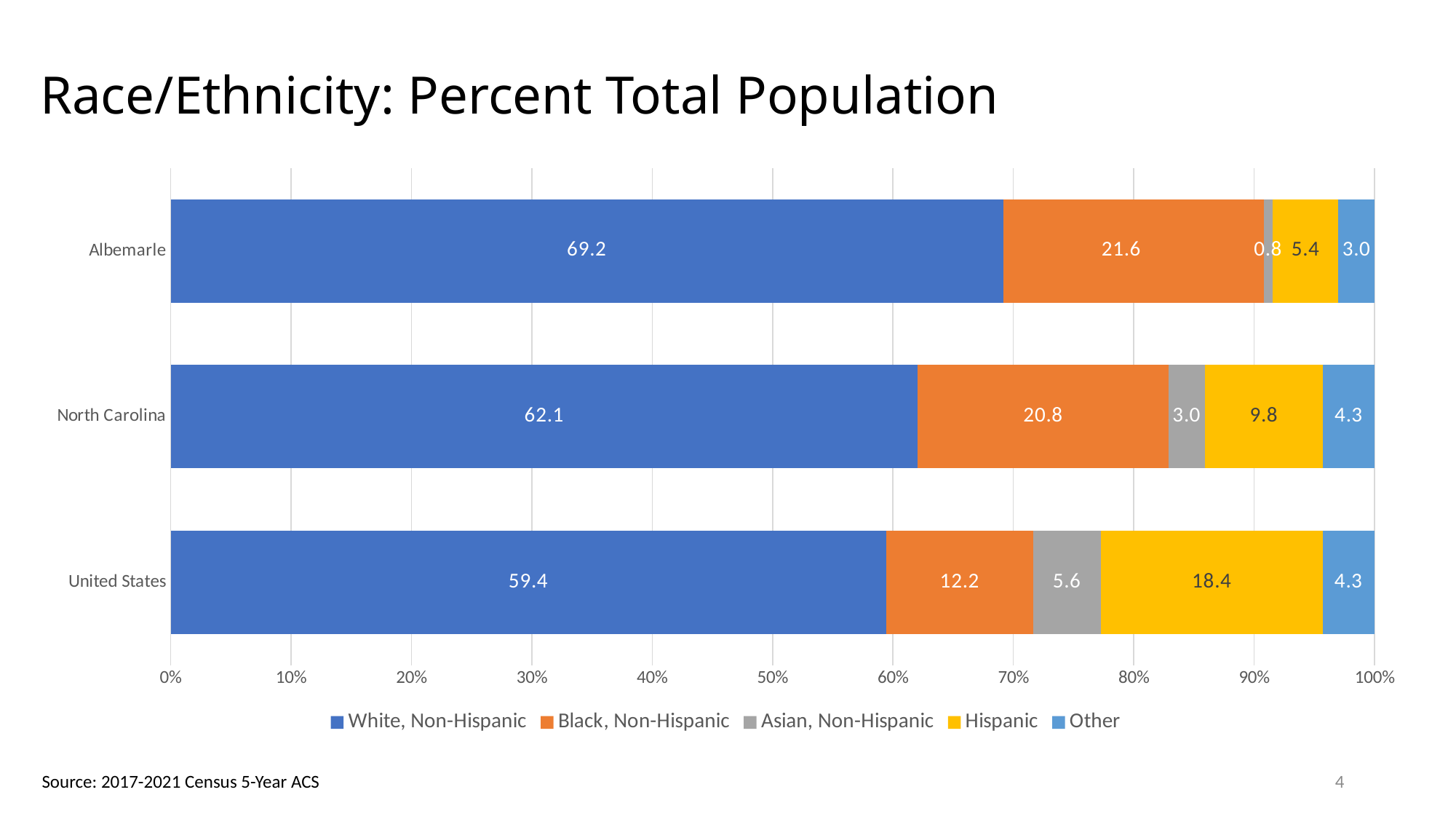
What is the White, Non-Hispanic value for Albemarle? 69.2 Which category has the highest White, Non-Hispanic value? Albemarle What is the difference between the Hispanic values for the United States and Albemarle? 13.0 Which is larger, the Black, Non-Hispanic value for Albemarle or for North Carolina? Albemarle How many series does the legend list? 5 What is the title of the chart? Race/Ethnicity: Percent Total Population What kind of chart is shown? Stacked bar chart What is the Hispanic value for the United States? 18.4 Which category has the lowest Black, Non-Hispanic value? United States What is the Asian, Non-Hispanic value for North Carolina? 3.0 How many categories are shown on the y axis? 3 What is the total of the stacked bar for North Carolina? 100.0